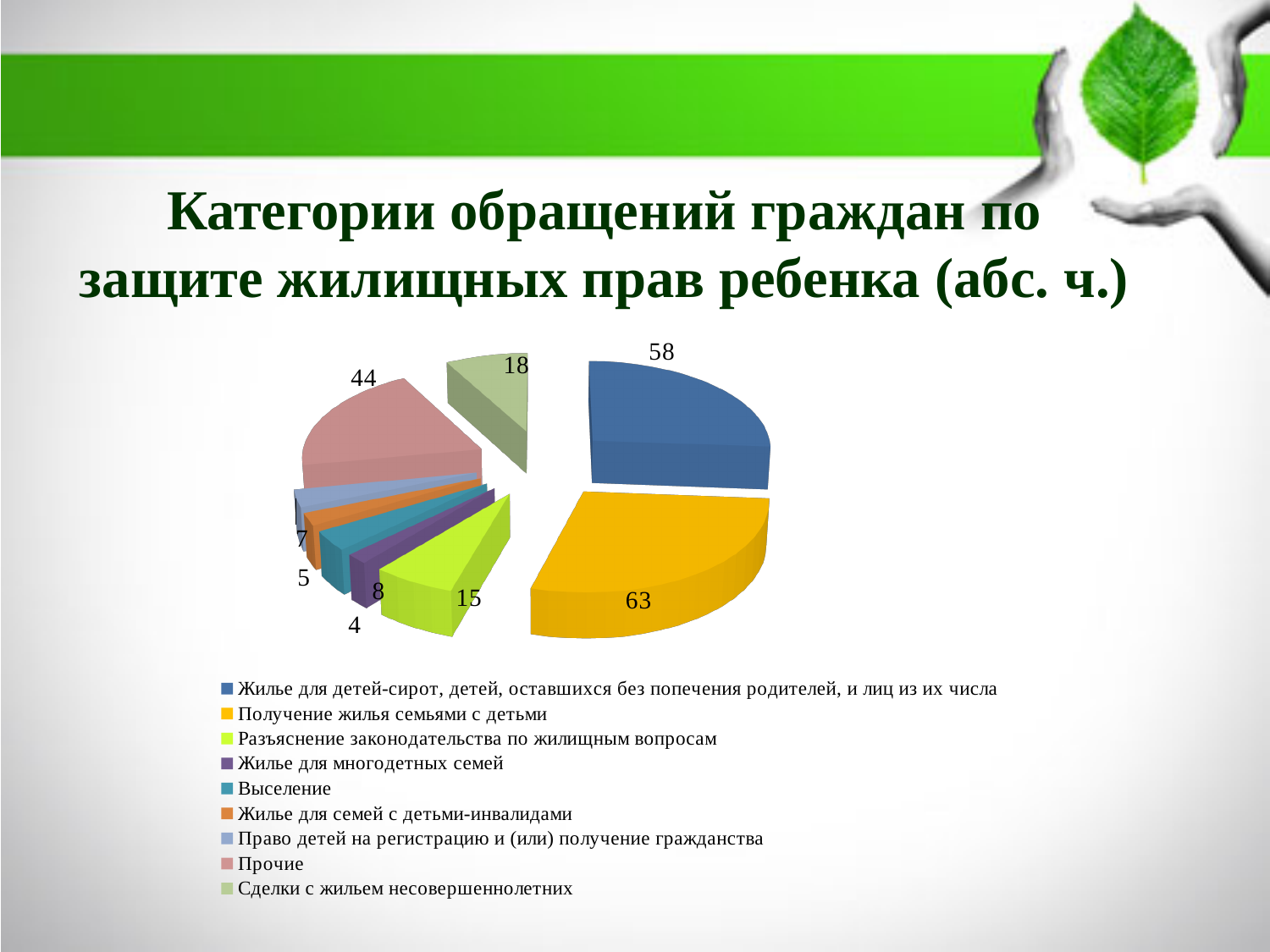
What is the value for 'Сделки с жильем несовершеннолетних'? 18 What is the value for 'Жилье для детей-сирот, детей, оставшихся без попечения родителей, и лиц из их числа'? 58 What is the difference between the values for 'Получение жилья семьями с детьми' and 'Жилье для детей-сирот, детей, оставшихся без попечения родителей, и лиц из их числа'? 5 Which is larger, the value for 'Прочие' or the value for 'Сделки с жильем несовершеннолетних'? Прочие How many categories does the legend list? 9 What is the value for 'Получение жилья семьями с детьми'? 63 Which category has the largest value? Получение жилья семьями с детьми What is the title of the chart? Категории обращений граждан по защите жилищных прав ребенка (абс. ч.) What is the value for 'Прочие'? 44 What kind of chart is shown on the slide? pie chart What is the value for 'Разъяснение законодательства по жилищным вопросам'? 15 What is the smallest value labelled on the chart? 4